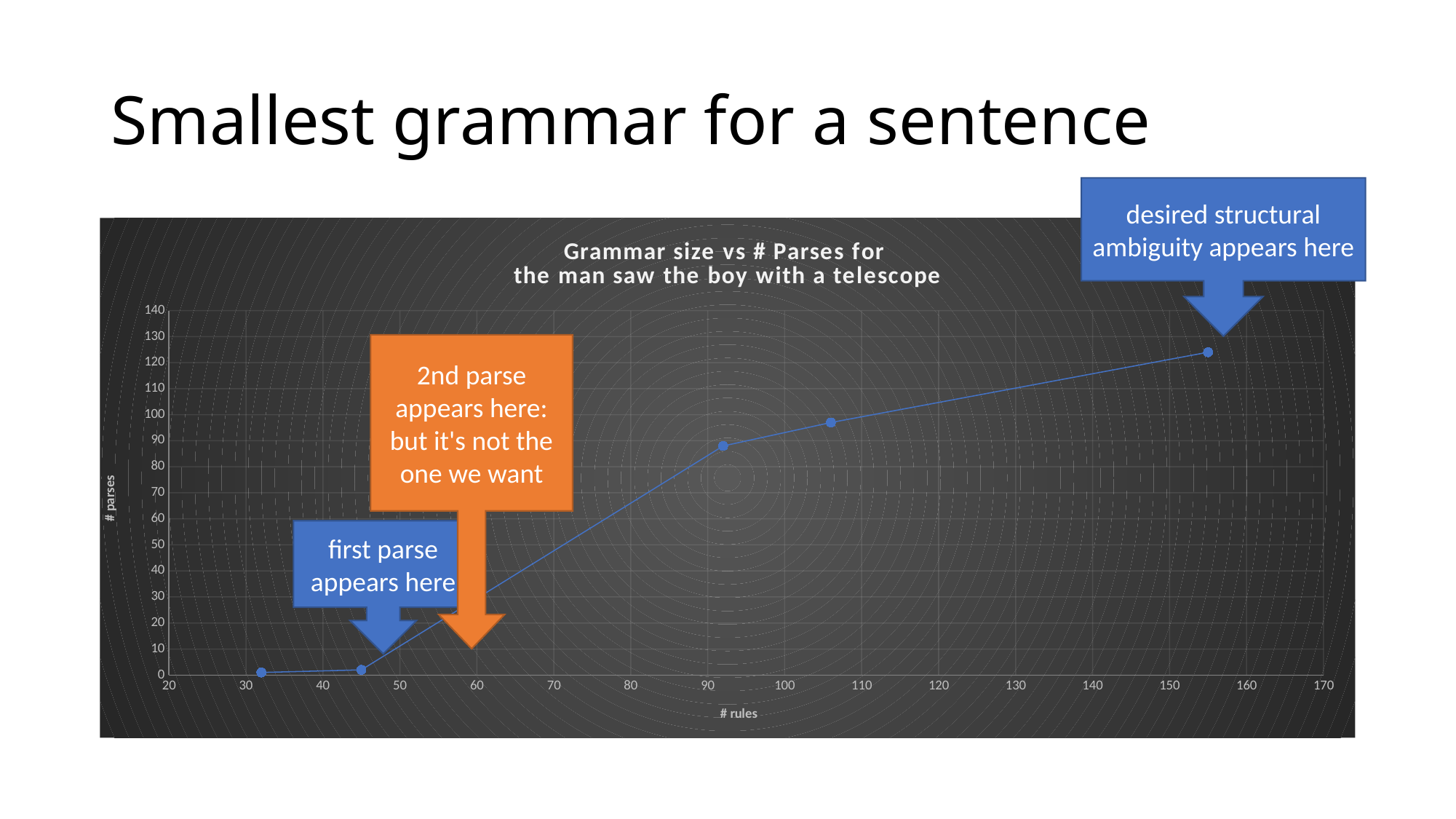
Is the value of # parses for the data point at around 92 rules greater or less than 100? less What is the title of the chart? Grammar size vs # Parses for the man saw the boy with a telescope What kind of chart is shown on the slide? line chart What is the highest value shown on the y axis? 140 Is the value of # parses for the rightmost data point (around 155 rules) greater or less than 110? greater Which data point has the lowest number of parses? the leftmost point, at around 32 rules Do the values of # parses rise or fall as # rules increases along the x axis? rise Is the value of # parses for the leftmost data point (around 32 rules) greater or less than 10? less How many data points are plotted on the chart? 5 What is the label of the x axis? # rules Which data point has the highest number of parses: the one at around 92 rules or the one at around 155 rules? the one at around 155 rules